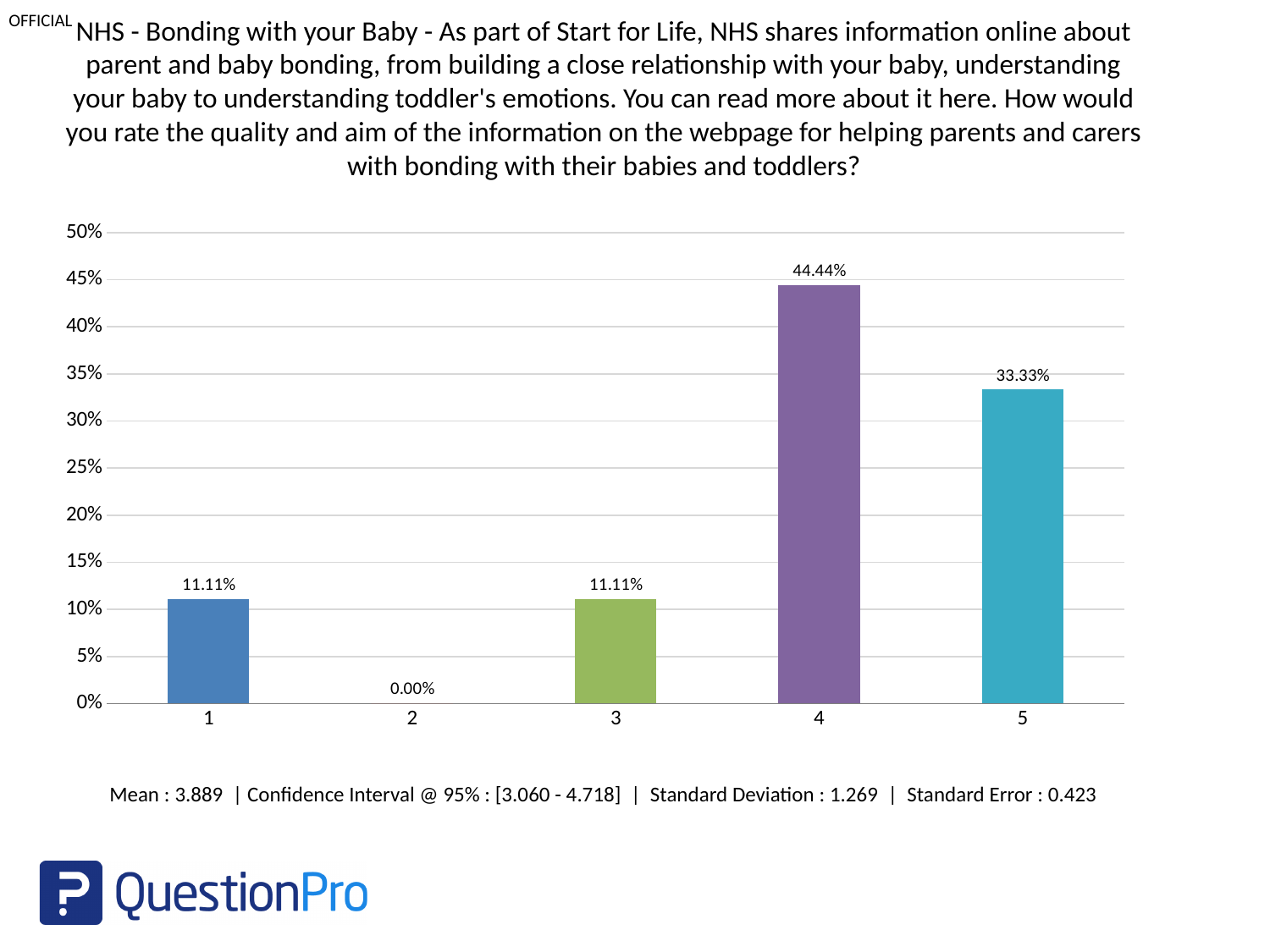
Is the value for rating 4 greater or less than 40%? greater How many rating categories are shown on the x axis? 5 What kind of chart is shown on the slide? bar chart What is the value for rating 1? 11.11% What mean value is reported below the chart? 3.889 Which rating has the highest value? 4 What is the value for rating 4? 44.44% What is the value for rating 2? 0.00% What is the difference between the values for rating 4 and rating 5? 11.11% Which rating has the lowest value? 2 Which is larger, the value for rating 5 or the value for rating 3? rating 5 What is the value for rating 5? 33.33%